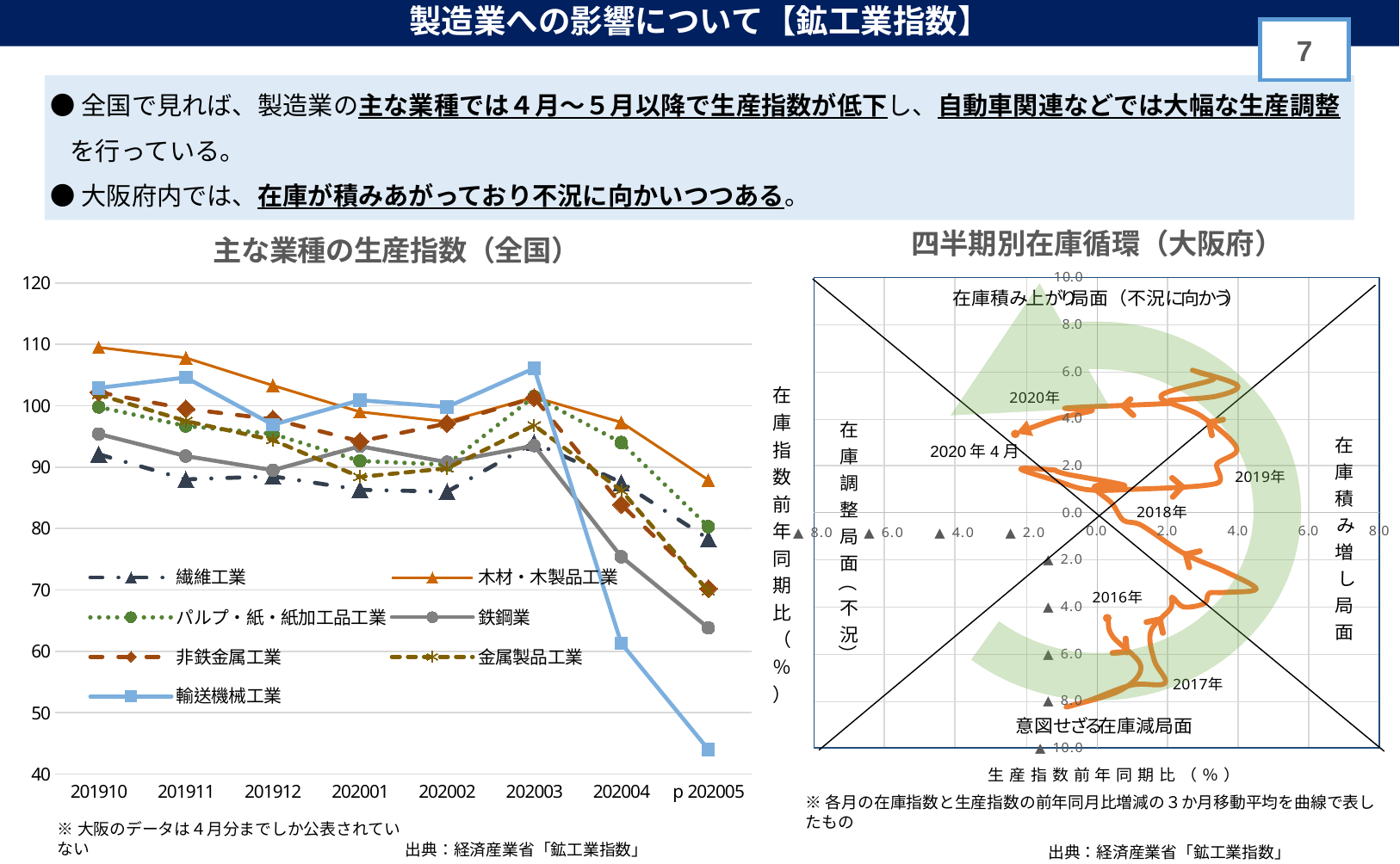
In the left chart 主な業種の生産指数（全国）, is the value for 輸送機械工業 at p 202005 greater or less than 50? less In the left chart 主な業種の生産指数（全国）, how many series does the legend list? 7 In the left chart 主な業種の生産指数（全国）, which series has the highest value at 201910? 木材・木製品工業 In the left chart 主な業種の生産指数（全国）, which series has the highest value at p 202005? 木材・木製品工業 In the left chart 主な業種の生産指数（全国）, how many time points are shown on the x axis? 8 In the left chart 主な業種の生産指数（全国）, is the value for 木材・木製品工業 at 201910 greater or less than 100? greater In the left chart 主な業種の生産指数（全国）, is the value for 鉄鋼業 at p 202005 greater or less than 70? less In the left chart 主な業種の生産指数（全国）, which series has the lowest value at p 202005? 輸送機械工業 In the left chart 主な業種の生産指数（全国）, does the value for 輸送機械工業 rise or fall from 202003 to p 202005? fall What is the x-axis title of the right chart titled 四半期別在庫循環（大阪府）? 生産指数前年同期比（％） In the left chart 主な業種の生産指数（全国）, at 201910, which is larger: 木材・木製品工業 or 繊維工業? 木材・木製品工業 What kind of chart is the left chart titled 主な業種の生産指数（全国）? line chart